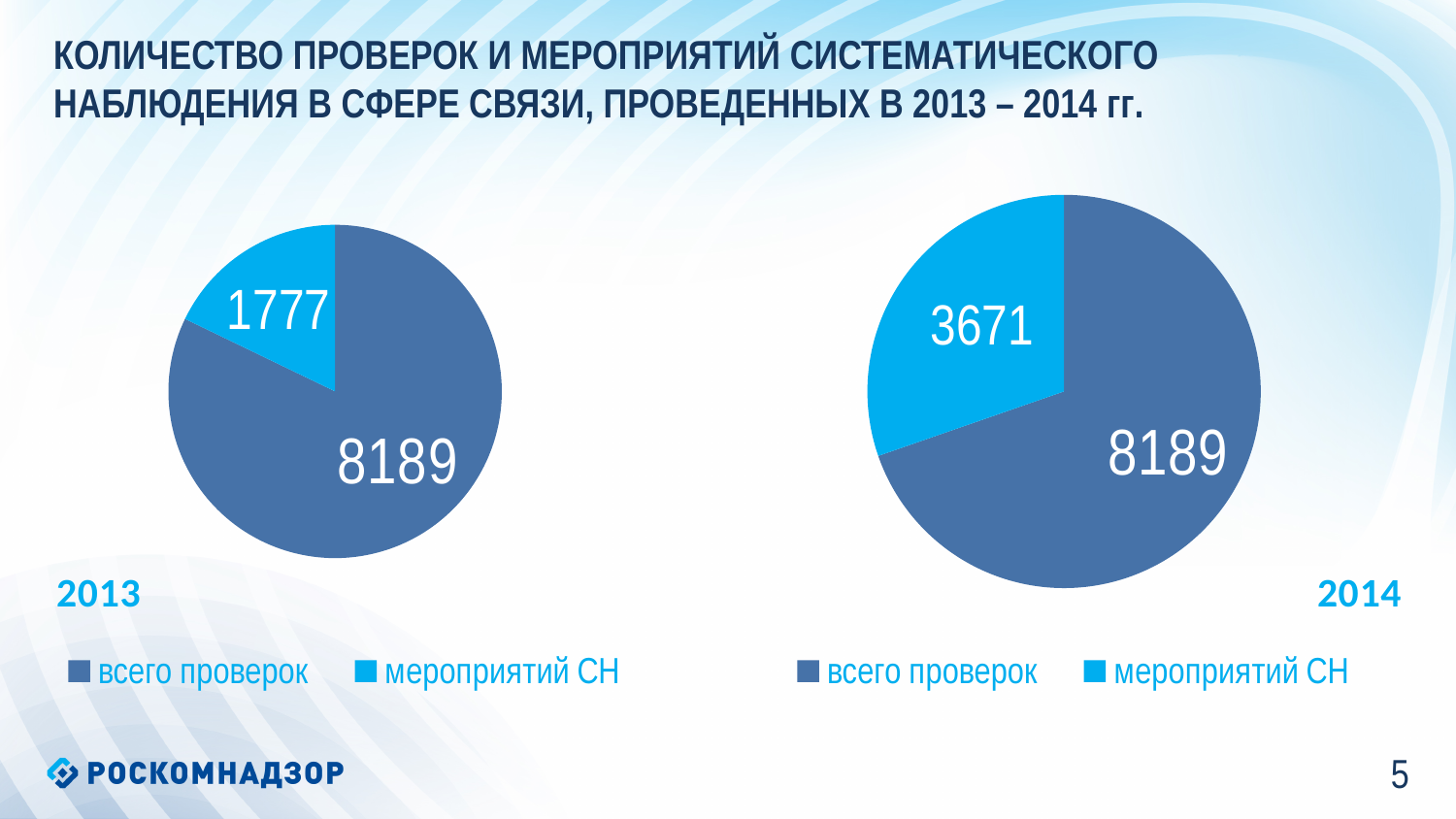
Which is larger: "мероприятий СН" in the 2013 chart or in the 2014 chart? 2014 In the 2013 pie chart, which slice is the largest? всего проверок In the 2014 pie chart, which slice is the smallest? мероприятий СН In the 2013 pie chart, what is the value for "всего проверок"? 8189 In the 2013 pie chart, what is the total of the two slices? 9966 In the 2014 pie chart, what is the value for "всего проверок"? 8189 Comparing the two pie charts, by how much did "мероприятий СН" increase from 2013 to 2014? 1894 What type of chart is used for the 2013 data on the slide? pie chart In the 2013 pie chart, what is the value for "мероприятий СН"? 1777 In the 2014 pie chart, what is the value for "мероприятий СН"? 3671 How many series does the legend of the 2014 pie chart list? 2 In the 2014 pie chart, what is the difference between "всего проверок" and "мероприятий СН"? 4518